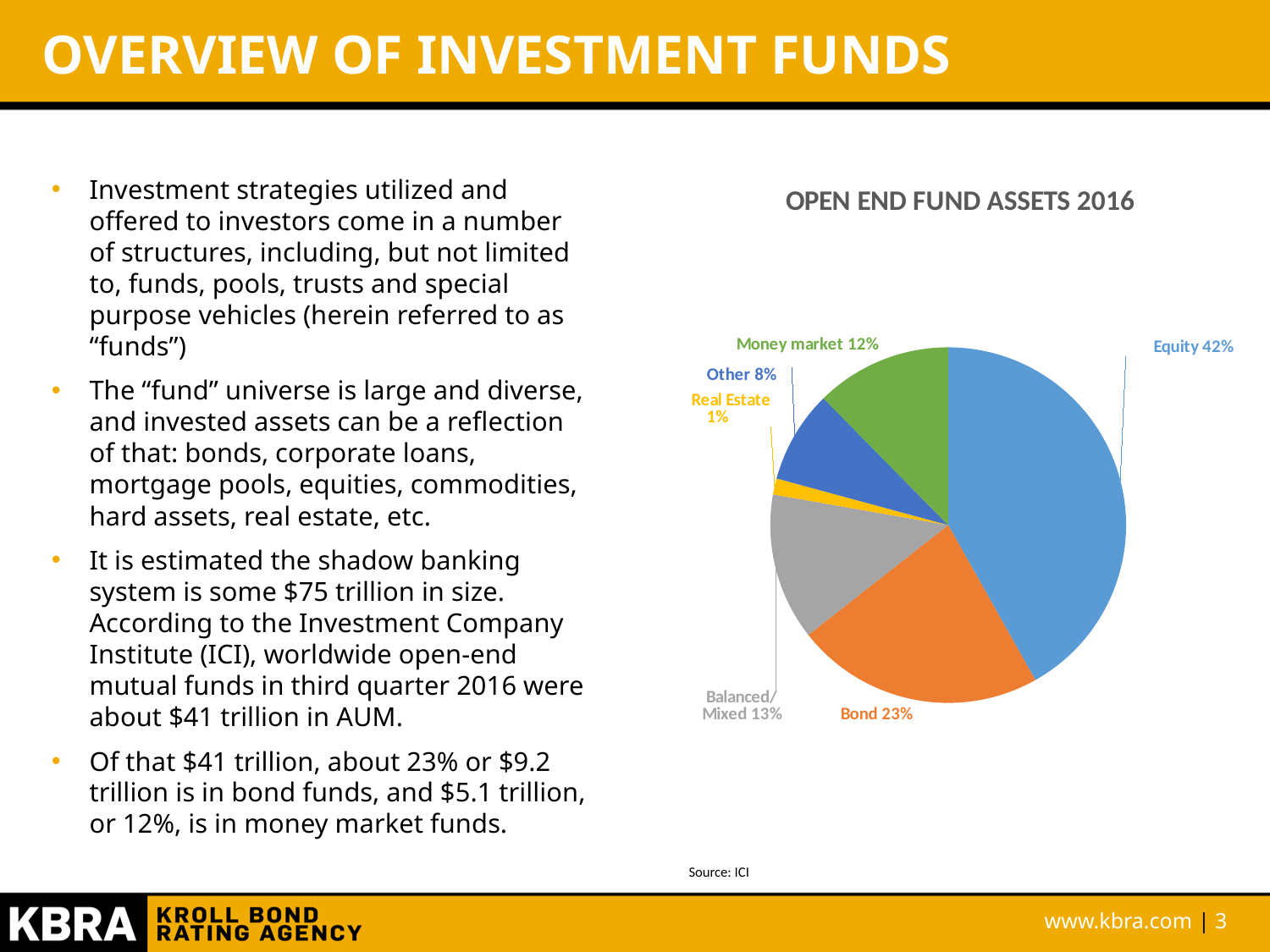
How many categories are shown in the pie chart? 6 What is the difference in percentage points between the Equity and Bond shares? 19 Which category has the largest share of open end fund assets? Equity What share of open end fund assets is in Money market funds? 12% What share of open end fund assets is in Bond funds? 23% Which category has the smallest share of open end fund assets? Real Estate What is the title of the chart? OPEN END FUND ASSETS 2016 Which is larger, the Balanced/Mixed share or the Other share? Balanced/Mixed What kind of chart is shown on the slide? pie chart What is the source cited for the chart? ICI What share of open end fund assets is in Equity? 42% What share of open end fund assets is in Real Estate? 1%